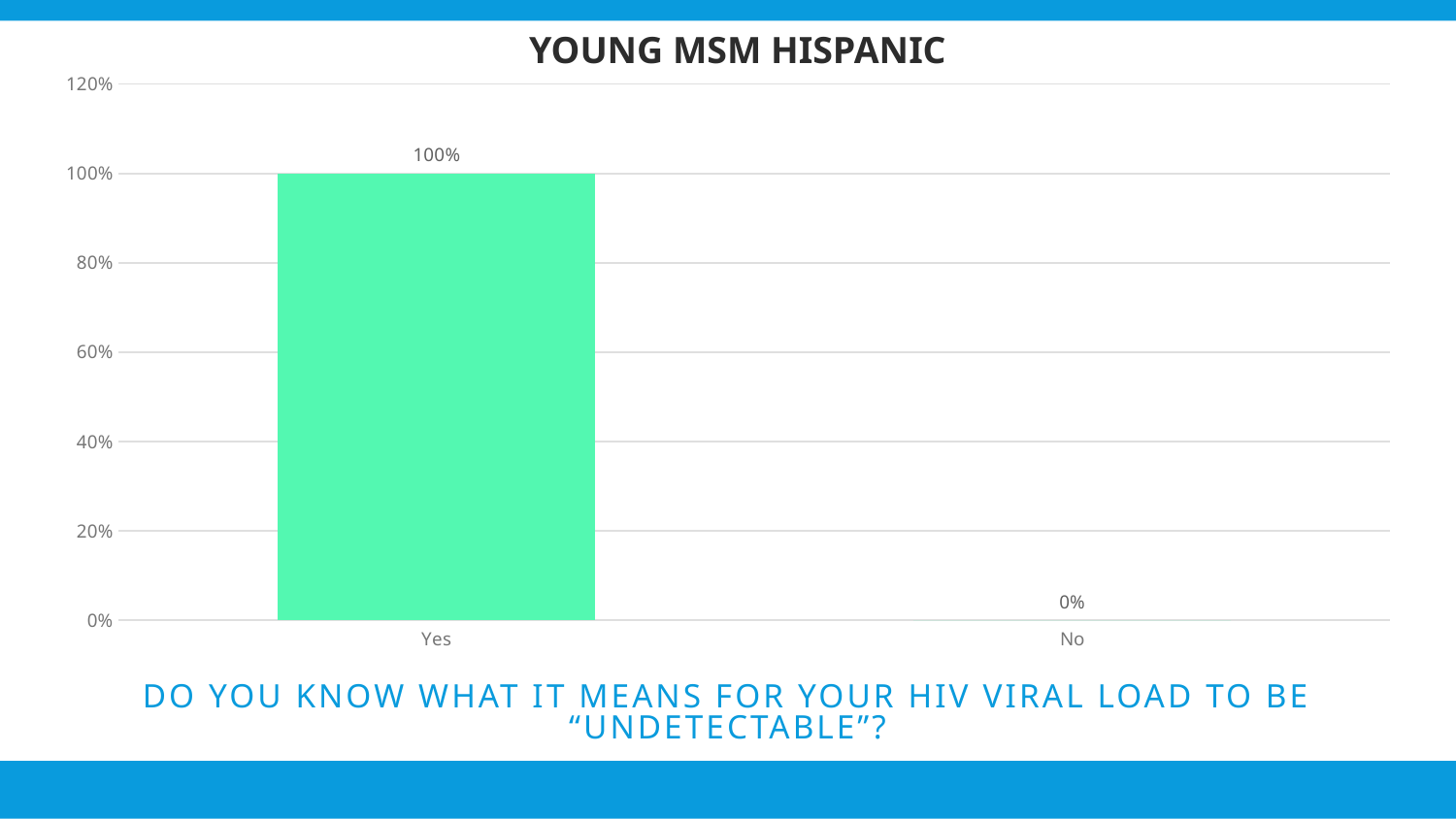
Do the values rise or fall from Yes to No along the x axis? fall Which category has the lowest value? No Which is larger, the value for Yes or the value for No? Yes What is the difference between the values for Yes and No? 100% How many categories are shown on the x axis? 2 What is the highest value shown on the y axis? 120% What is the value for Yes? 100% Is the value for Yes greater or less than 80%? greater Which category has the highest value? Yes What is the value for No? 0% What is the title of the chart? YOUNG MSM HISPANIC What kind of chart is shown on the slide? bar chart